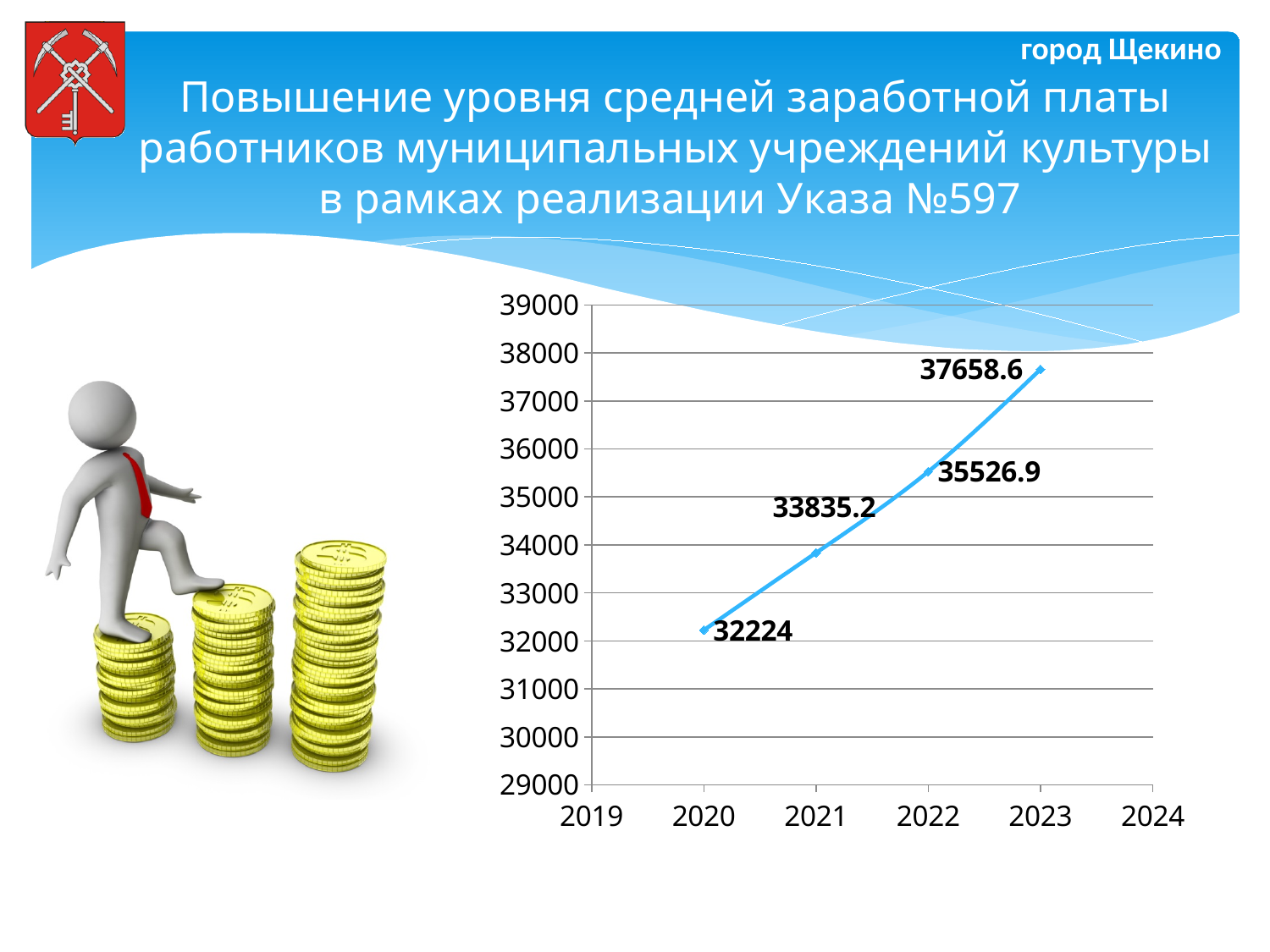
Which is larger, the value for 2021 or the value for 2022? 2022 Which year has the lowest plotted value? 2020 Do the values rise or fall from 2020 to 2023? rise What is the difference between the values for 2023 and 2020? 5434.6 What is the difference between the values for 2022 and 2021? 1691.7 Which year has the highest plotted value? 2023 What is the value plotted for 2023? 37658.6 What is the value plotted for 2022? 35526.9 What is the value plotted for 2020? 32224 How many data points are plotted on the line? 4 What is the value plotted for 2021? 33835.2 What kind of chart is shown on the slide? line chart